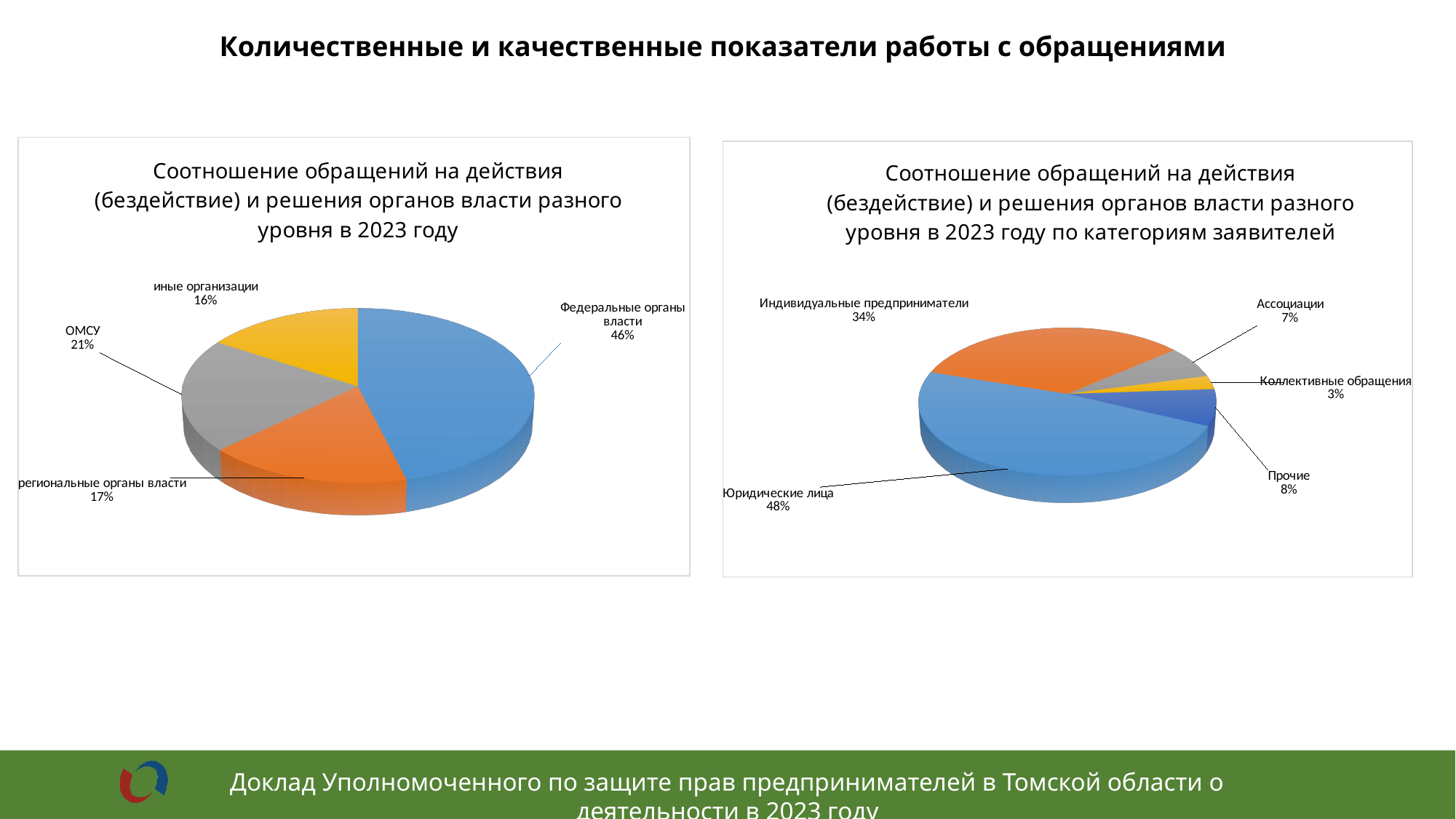
In the left chart, what is the difference between the shares of ОМСУ and региональные органы власти? 4% In the left chart, which category has the smallest share? иные организации In the right chart, which category has the largest share? Юридические лица In the right chart, which is larger: Прочие or Ассоциации? Прочие In the right chart, what share is shown for Коллективные обращения? 3% How many categories does the left pie chart show? 4 In the left chart (Соотношение обращений ... в 2023 году), what share is shown for Федеральные органы власти? 46% In the left chart, which category has the largest share? Федеральные органы власти In the right chart (по категориям заявителей), what share is shown for Индивидуальные предприниматели? 34% What type of chart is used on the right side of the slide? Pie chart In the left chart, what share is shown for ОМСУ? 21% How many categories does the right pie chart show? 5